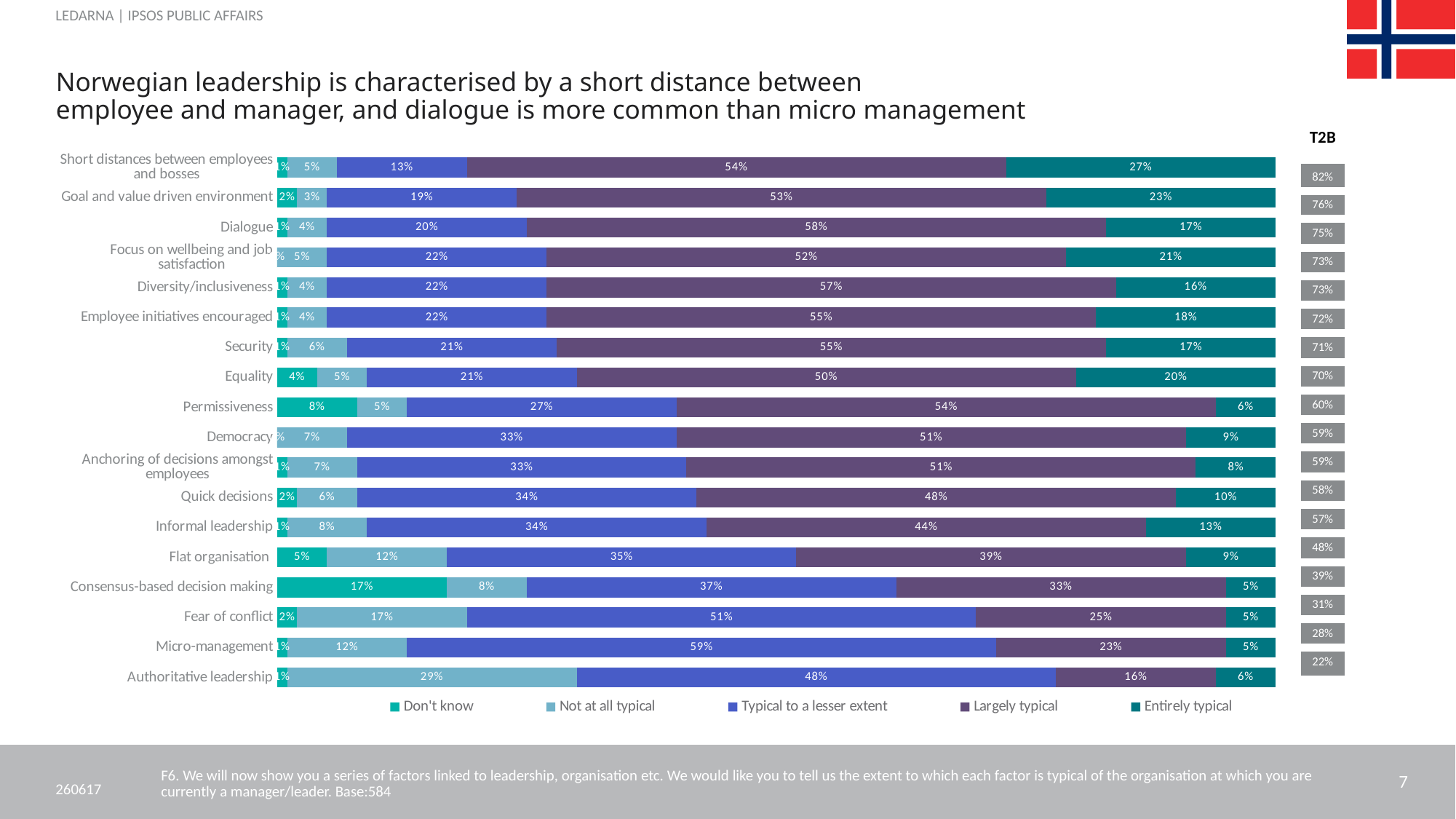
Which category has the highest "Typical to a lesser extent" value? Micro-management What kind of chart is shown on the slide? Stacked bar chart What is the "Not at all typical" value for Authoritative leadership? 29% What percentage of respondents rated Dialogue as "Largely typical"? 58% Which category has the highest "Entirely typical" value? Short distances between employees and bosses How many leadership factors (categories) are shown in the chart? 18 What is the T2B value shown for Authoritative leadership? 22% How many series does the legend list? 5 What is the difference in percentage points between the "Largely typical" values for Dialogue and Flat organisation? 19 percentage points Which has a larger "Largely typical" value, Security or Informal leadership? Security What is the "Don't know" value for Consensus-based decision making? 17% What is the "Entirely typical" value for Short distances between employees and bosses? 27%